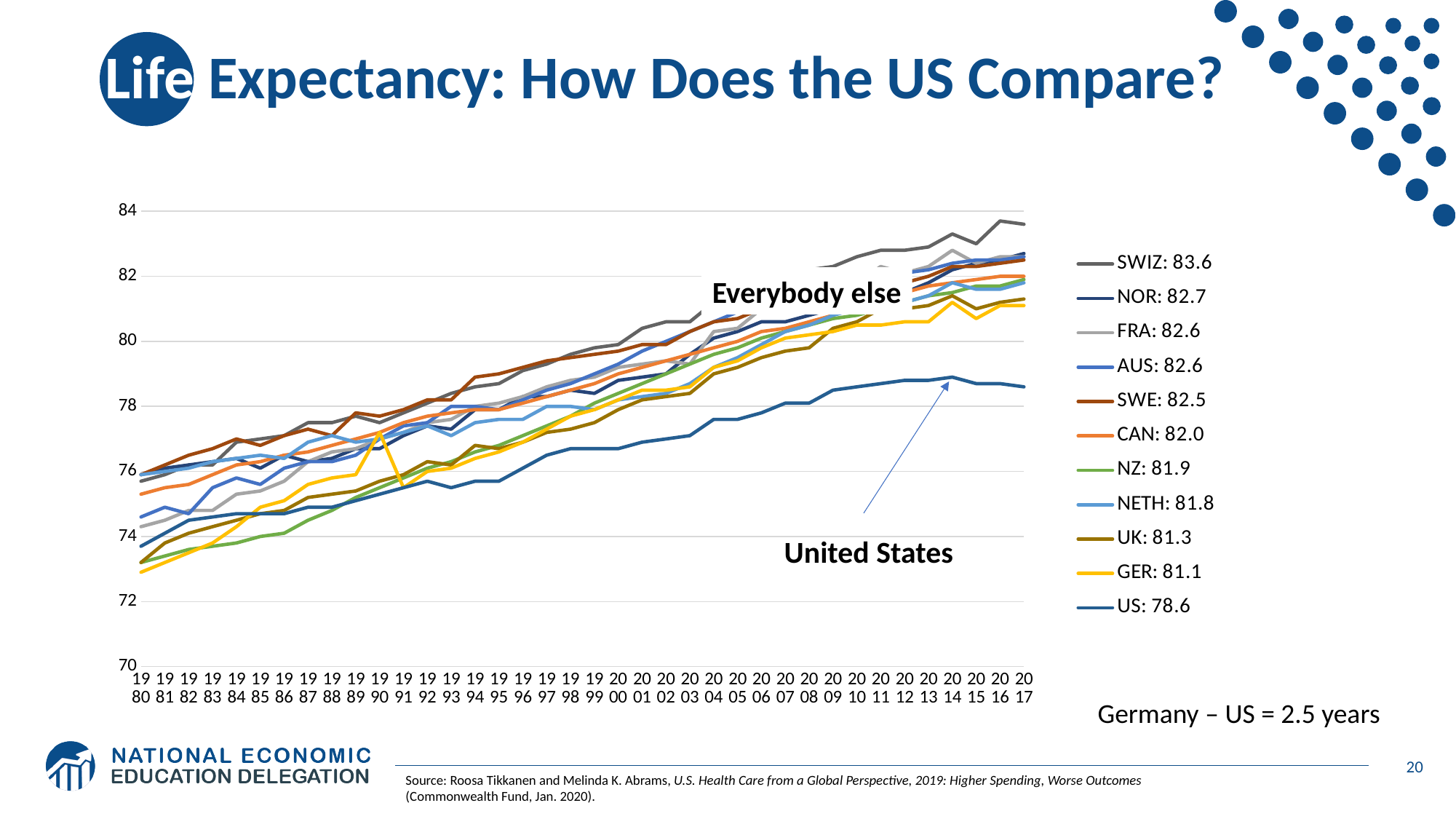
What value is shown for the US in the legend? 78.6 Is the value for the US in 2017 greater or less than 80? less Which country has the lowest life expectancy value in the legend? US Which country has the highest life expectancy value in the legend? SWIZ How many series does the legend list? 11 What is the difference between the SWIZ value and the US value shown in the legend? 5.0 What type of chart is shown on the slide? line chart What value is shown for GER in the legend? 81.1 What value is shown for SWIZ in the legend? 83.6 Which has a higher value in the legend, NOR or CAN? NOR Do the life expectancy lines generally rise or fall from 1980 to 2017? rise According to the text on the slide, what is the gap between Germany and the US in years? 2.5 years